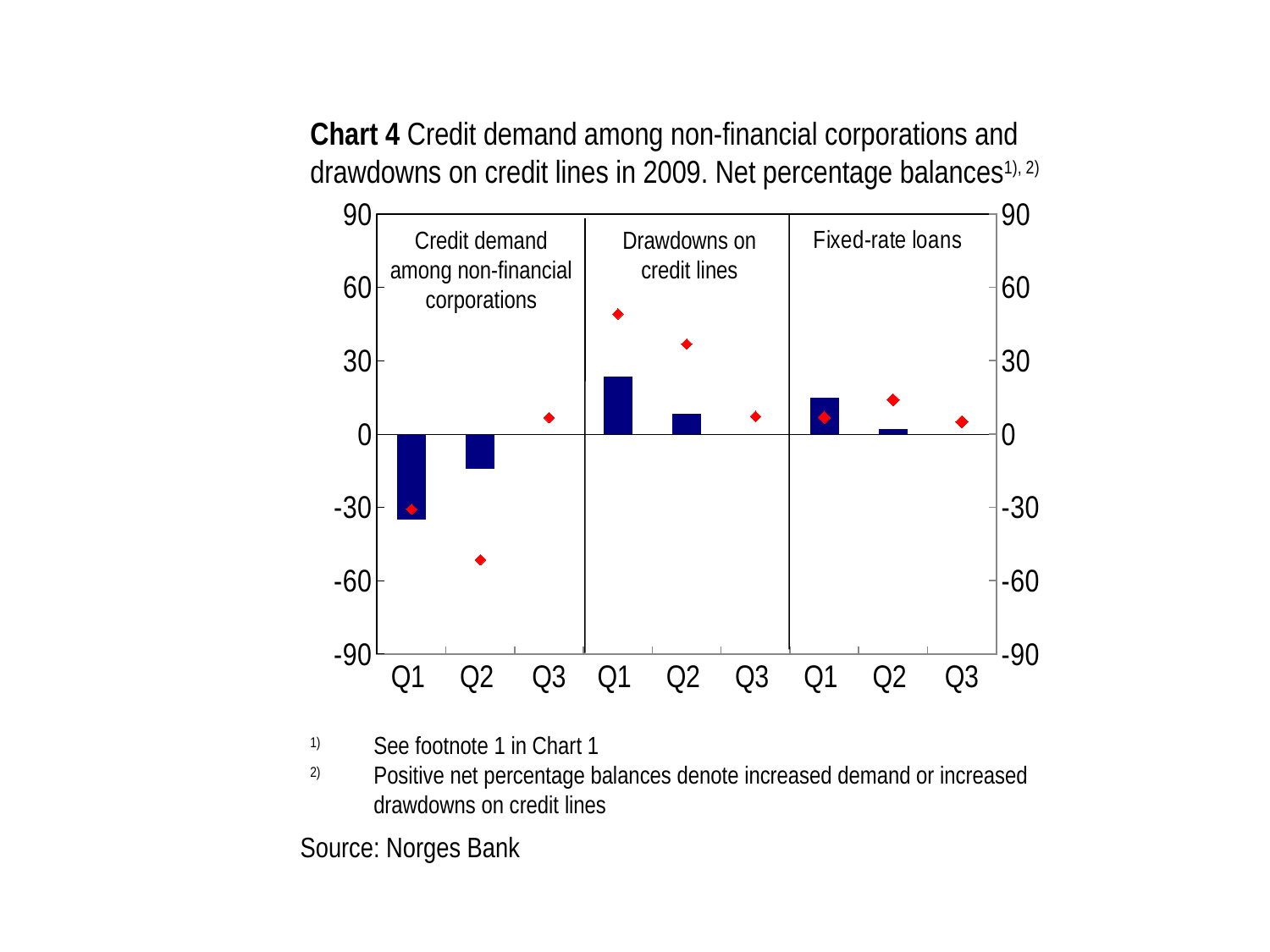
In the 'Drawdowns on credit lines' panel, is the bar for Q1 greater or less than 30? less How many quarter labels are shown along the x axis in total? 9 Across all three panels, which quarter and panel has the lowest red diamond? Q2, Credit demand among non-financial corporations In the 'Fixed-rate loans' panel, is the bar for Q1 greater or less than 30? less What is the title of the third panel of the chart? Fixed-rate loans What kind of chart is shown on the slide? bar chart with red diamond markers (combination bar and marker chart) In the 'Drawdowns on credit lines' panel, is the red diamond for Q1 greater or less than 30? greater How many panels (sections) does the chart have? 3 Across all three panels, which quarter and panel has the highest red diamond? Q1, Drawdowns on credit lines In the 'Drawdowns on credit lines' panel, which bar is taller, Q1 or Q2? Q1